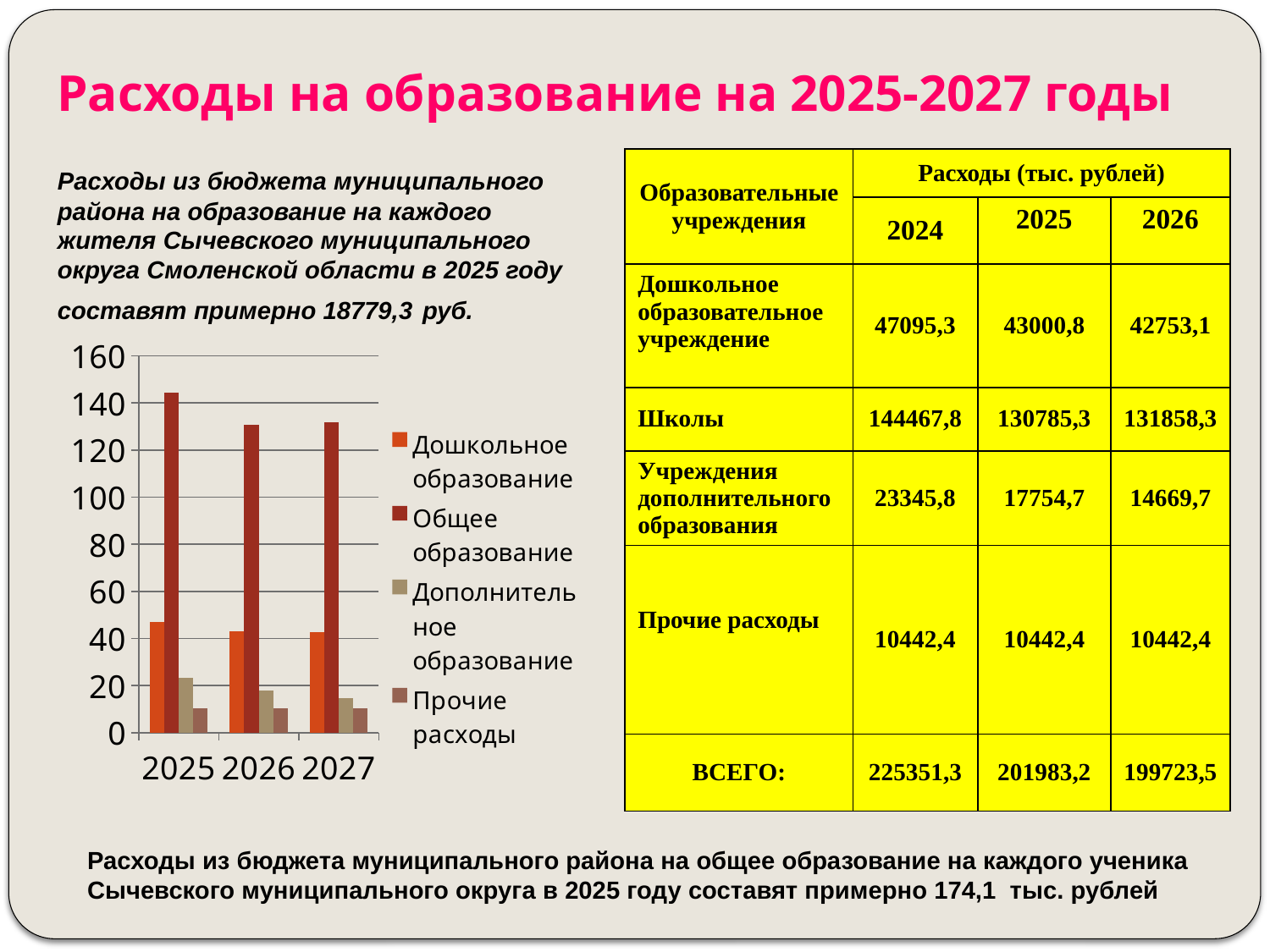
Do the values for Дополнительное образование rise or fall from 2025 to 2027? fall Which series has the lowest bars in the chart? Прочие расходы Is the value for Общее образование in 2025 greater or less than 140? greater How many series does the chart legend list? 4 Is the value for Дополнительное образование in 2027 greater or less than 20? less Which series has the tallest bar in the chart? Общее образование Is the value for Общее образование in 2026 greater or less than 120? greater In 2025, which is larger: Дошкольное образование or Дополнительное образование? Дошкольное образование How many year categories are shown on the x axis of the chart? 3 What kind of chart is shown on the slide? bar chart What is the highest value shown on the chart's vertical axis? 160